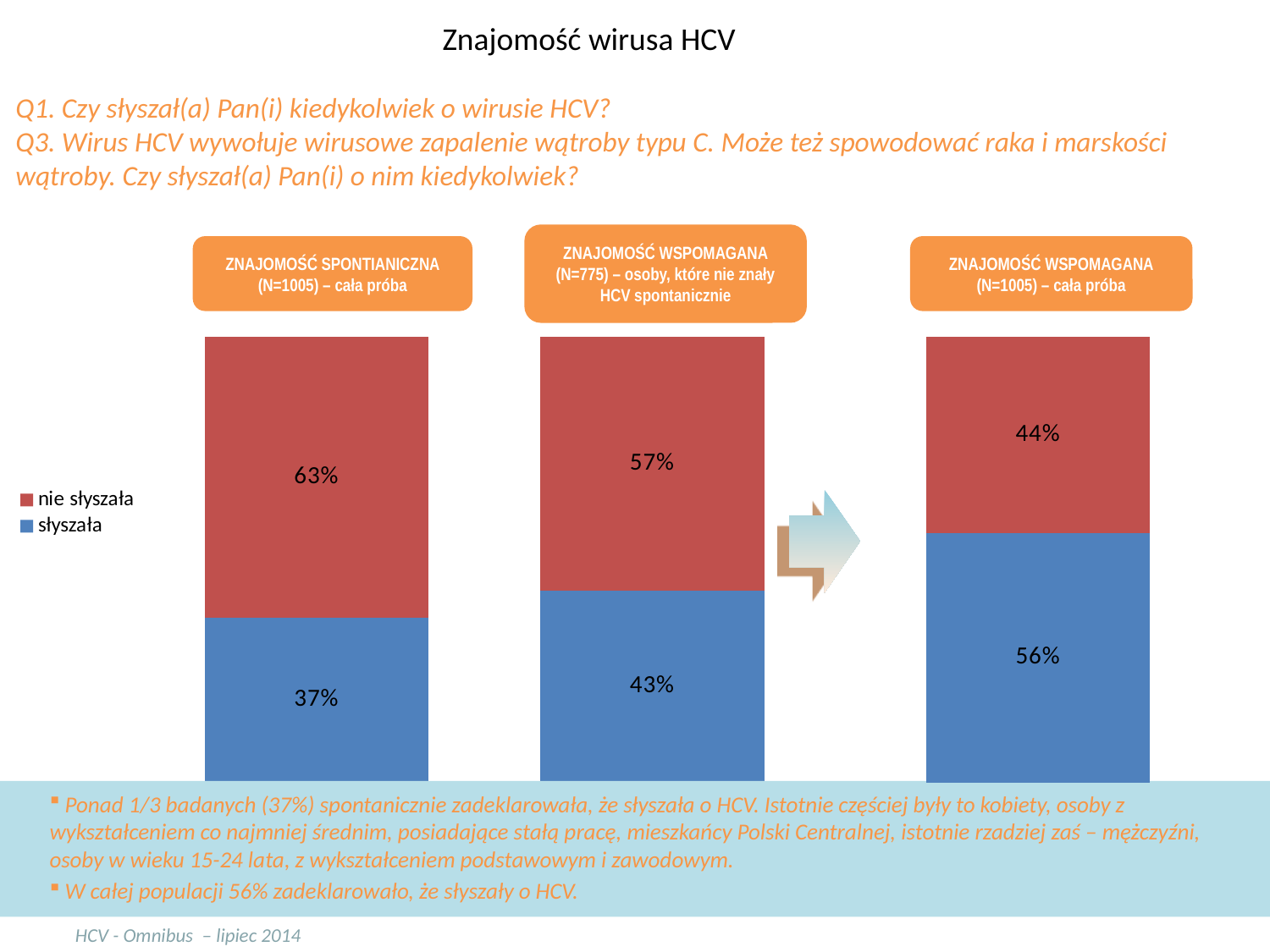
Which colour represents 'nie słyszała' in the legend? Red Which of the three bars has the highest 'słyszała' share? ZNAJOMOŚĆ WSPOMAGANA (N=1005) – cała próba What share of respondents in the 'ZNAJOMOŚĆ SPONTANICZNA (N=1005) – cała próba' bar answered 'nie słyszała'? 63% How many series does the legend list? 2 What is the difference between the 'nie słyszała' and 'słyszała' shares in the 'ZNAJOMOŚĆ SPONTANICZNA' bar? 26% What type of chart is shown on the slide? Stacked bar chart In the 'ZNAJOMOŚĆ WSPOMAGANA (N=1005) – cała próba' bar, which is larger: 'słyszała' or 'nie słyszała'? słyszała Which of the three bars has the lowest 'słyszała' share? ZNAJOMOŚĆ SPONTANICZNA (N=1005) – cała próba In the 'ZNAJOMOŚĆ WSPOMAGANA (N=775)' bar, what percentage is shown for 'słyszała'? 43% What share of respondents in the 'ZNAJOMOŚĆ SPONTANICZNA (N=1005) – cała próba' bar answered 'słyszała'? 37% In the 'ZNAJOMOŚĆ WSPOMAGANA (N=1005) – cała próba' bar, what percentage is shown for 'nie słyszała'? 44% How many stacked bars are shown on the slide? 3